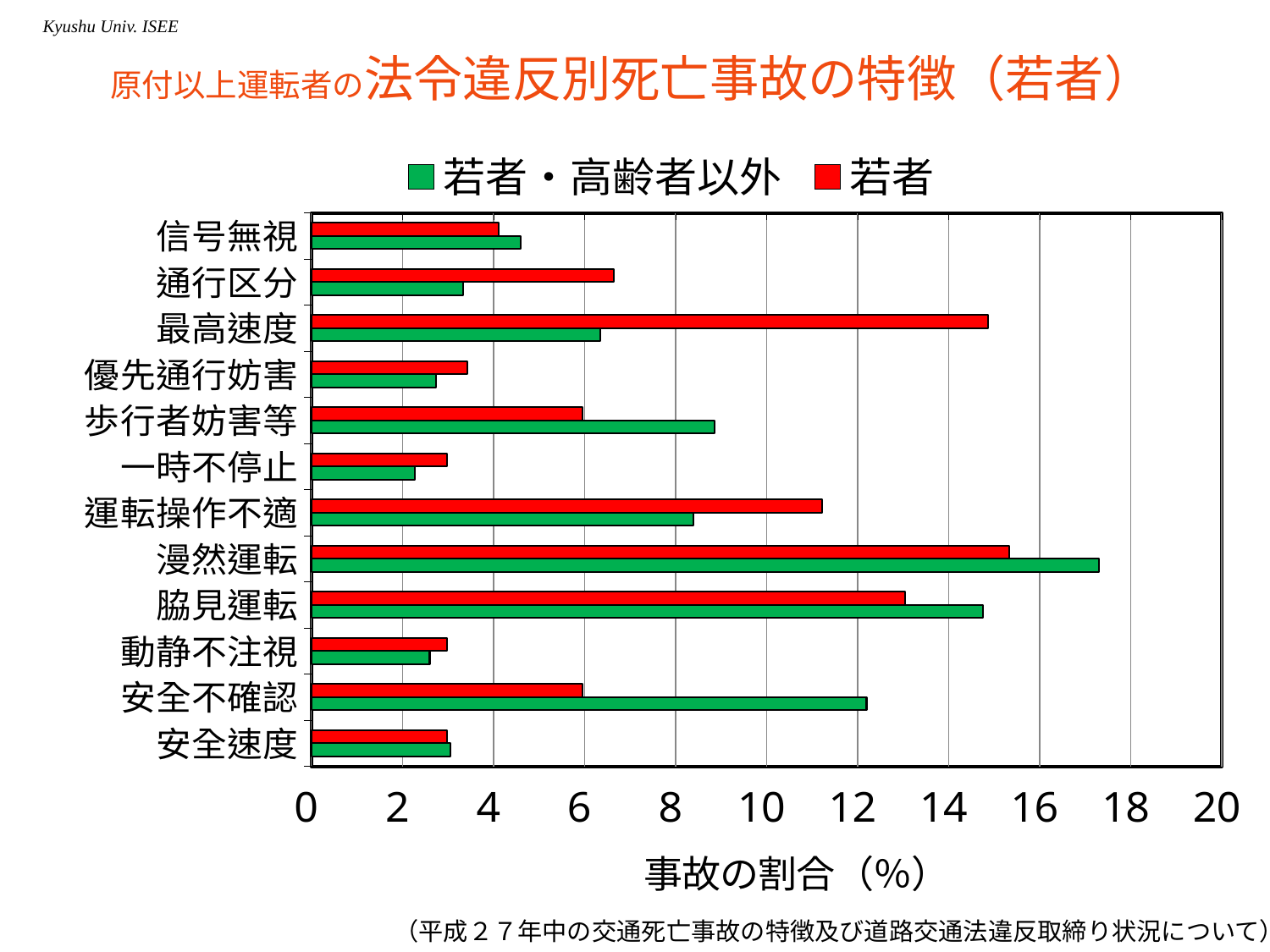
Which category has the highest value for the 若者・高齢者以外 series? 漫然運転 Is the 若者 value for 最高速度 greater or less than 14? greater What kind of chart is shown on the slide? bar chart Is the 若者・高齢者以外 value for 通行区分 greater or less than 4? less For 最高速度, which series has the larger value, 若者 or 若者・高齢者以外? 若者 How many violation categories are plotted on the y axis? 12 Which colour represents the 若者 series in the legend? red Is the 若者・高齢者以外 value for 漫然運転 greater or less than 16? greater For 安全不確認, which series has the larger value, 若者 or 若者・高齢者以外? 若者・高齢者以外 What is the label of the x axis? 事故の割合（%） How many series does the legend list? 2